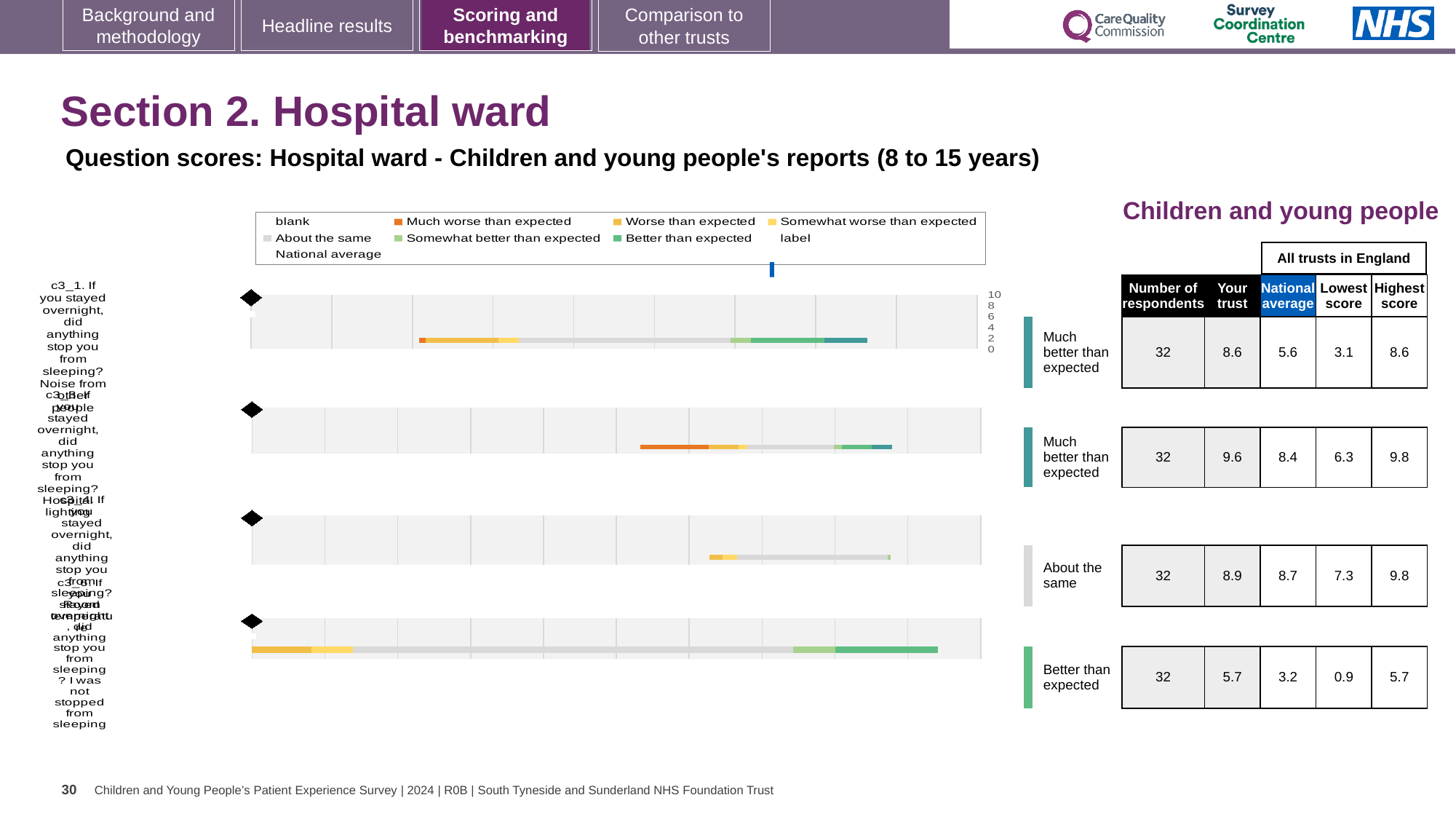
In the table beside the chart, what is the difference between the 'Your trust' score and the National average in the first row? 3.0 What kind of chart is shown on the slide? bar chart In the table beside the chart, what is the National average for the second row? 8.4 In the table beside the chart, which row has the lowest 'Your trust' score? the fourth row (5.7) How many entries does the chart's legend list? 9 In the table beside the chart, which row has the highest 'Your trust' score? the second row (9.6) What colour does the legend use for 'Much worse than expected'? orange What is the maximum value shown on the chart's axis? 10 In the table beside the chart, what is the 'Your trust' score for the first row (Much better than expected)? 8.6 In the table beside the chart, how many respondents are listed for each row? 32 How many horizontal bars are plotted in the chart? 4 In the table beside the chart, what is the Lowest score for the fourth row (Better than expected)? 0.9